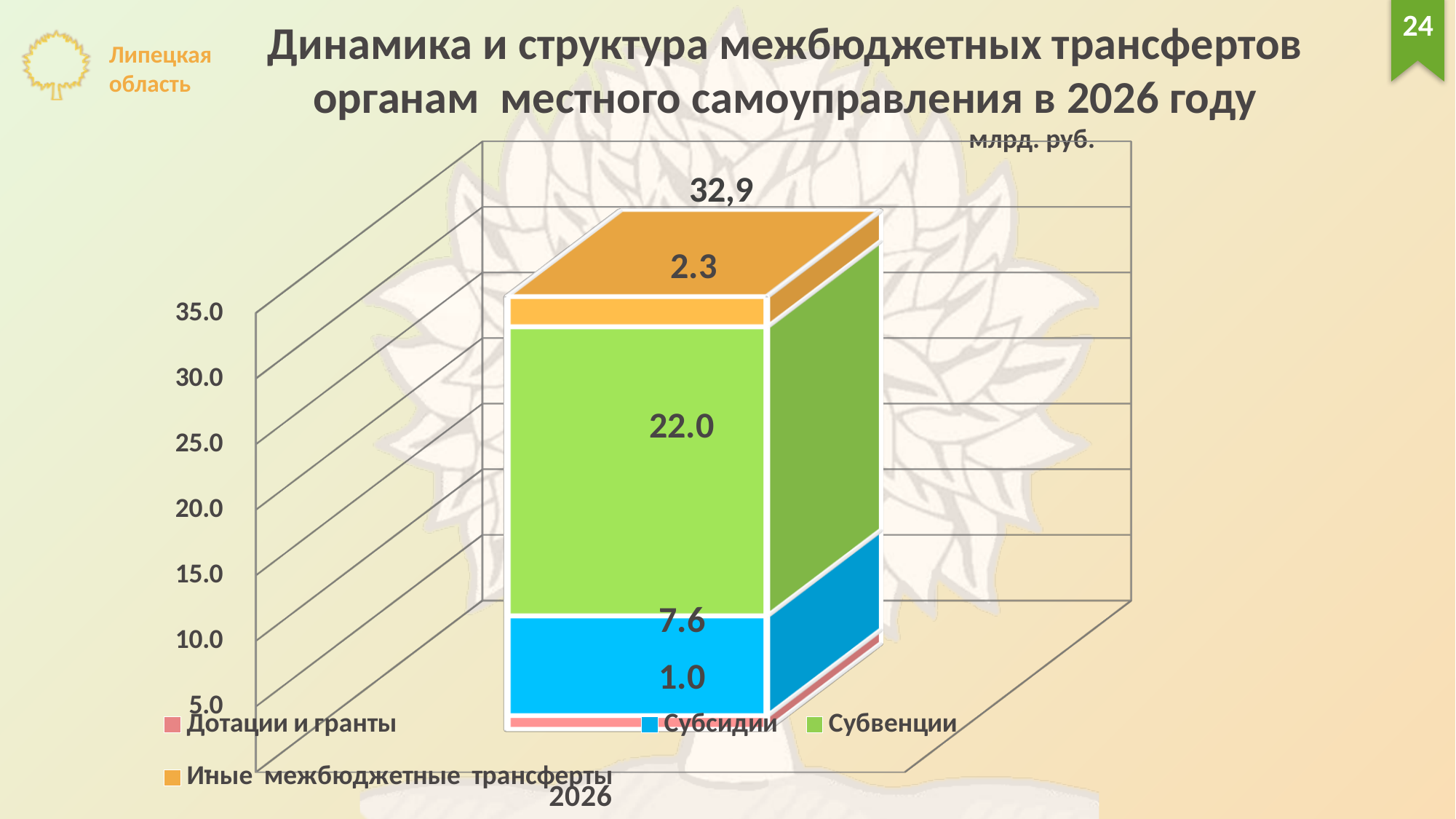
What is the value of the Субвенции segment in 2026? 22.0 How many series does the legend list? 4 What is the value of the Дотации и гранты segment? 1.0 What is the value of the Субсидии segment? 7.6 What unit is indicated for the chart values? млрд. руб. What is the total of the stacked bar for 2026? 32,9 What is the difference between the Субвенции and Субсидии values? 14.4 What kind of chart is shown on the slide? stacked bar chart What is the value of the Иные межбюджетные трансферты segment? 2.3 Which series has the largest segment in the 2026 bar? Субвенции Which is larger, Субсидии or Иные межбюджетные трансферты? Субсидии Which series has the smallest segment in the 2026 bar? Дотации и гранты